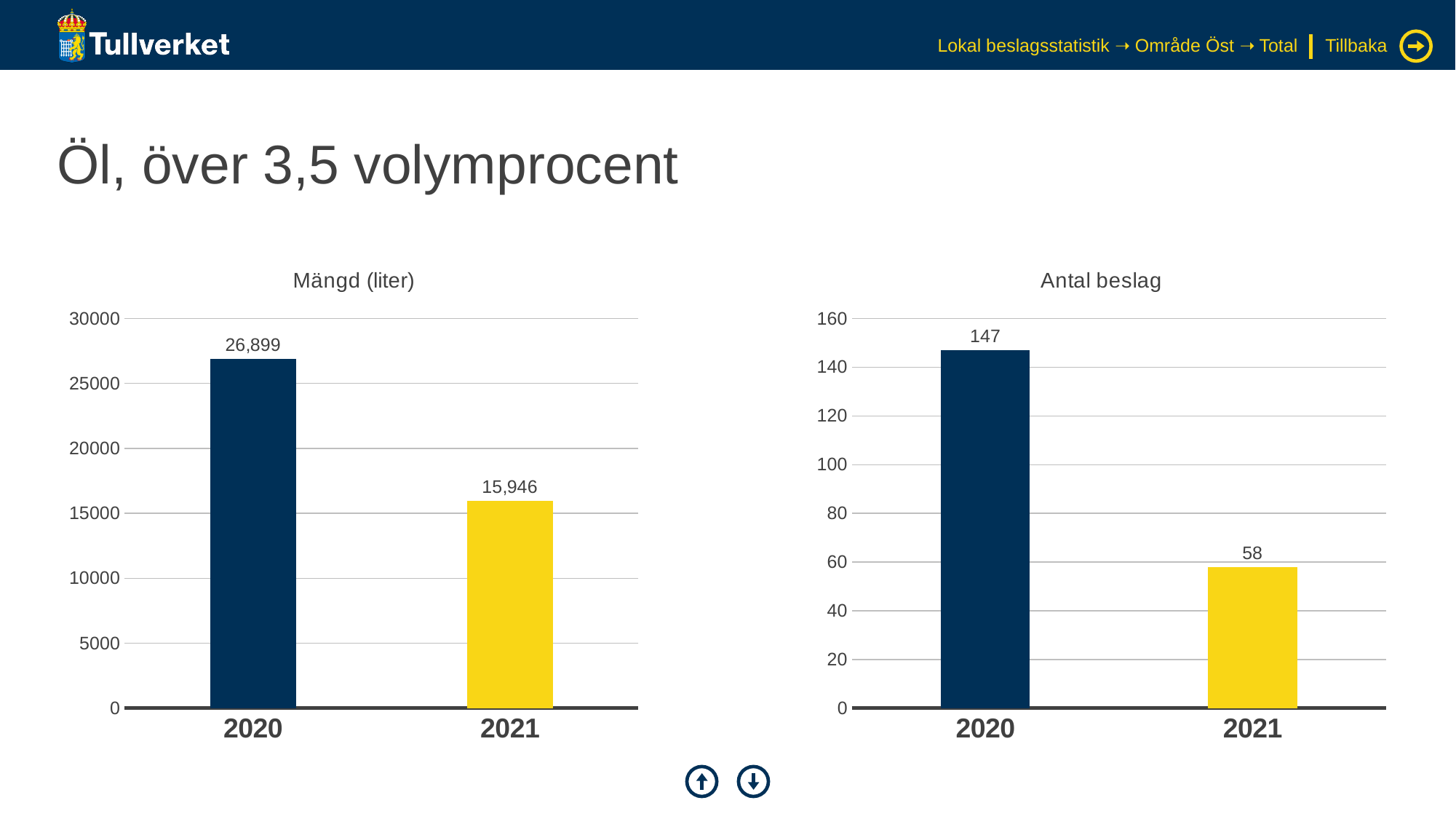
In the 'Antal beslag' chart, what is the value for 2021? 58 In the 'Mängd (liter)' chart, which year has the highest value? 2020 In the 'Mängd (liter)' chart, what is the difference between the 2020 and 2021 values? 10,953 In the 'Mängd (liter)' chart, what is the value for 2021? 15,946 In the 'Antal beslag' chart, is the value for 2020 greater or less than 140? greater In the 'Antal beslag' chart, what is the value for 2020? 147 In the 'Antal beslag' chart, which year has the lowest value? 2021 In the 'Antal beslag' chart, what is the difference between the 2020 and 2021 values? 89 What kind of chart is the 'Antal beslag' chart? bar chart In the 'Mängd (liter)' chart, how many years are shown on the x axis? 2 In the 'Mängd (liter)' chart, do the values rise or fall from 2020 to 2021? fall In the 'Mängd (liter)' chart, what is the value for 2020? 26,899